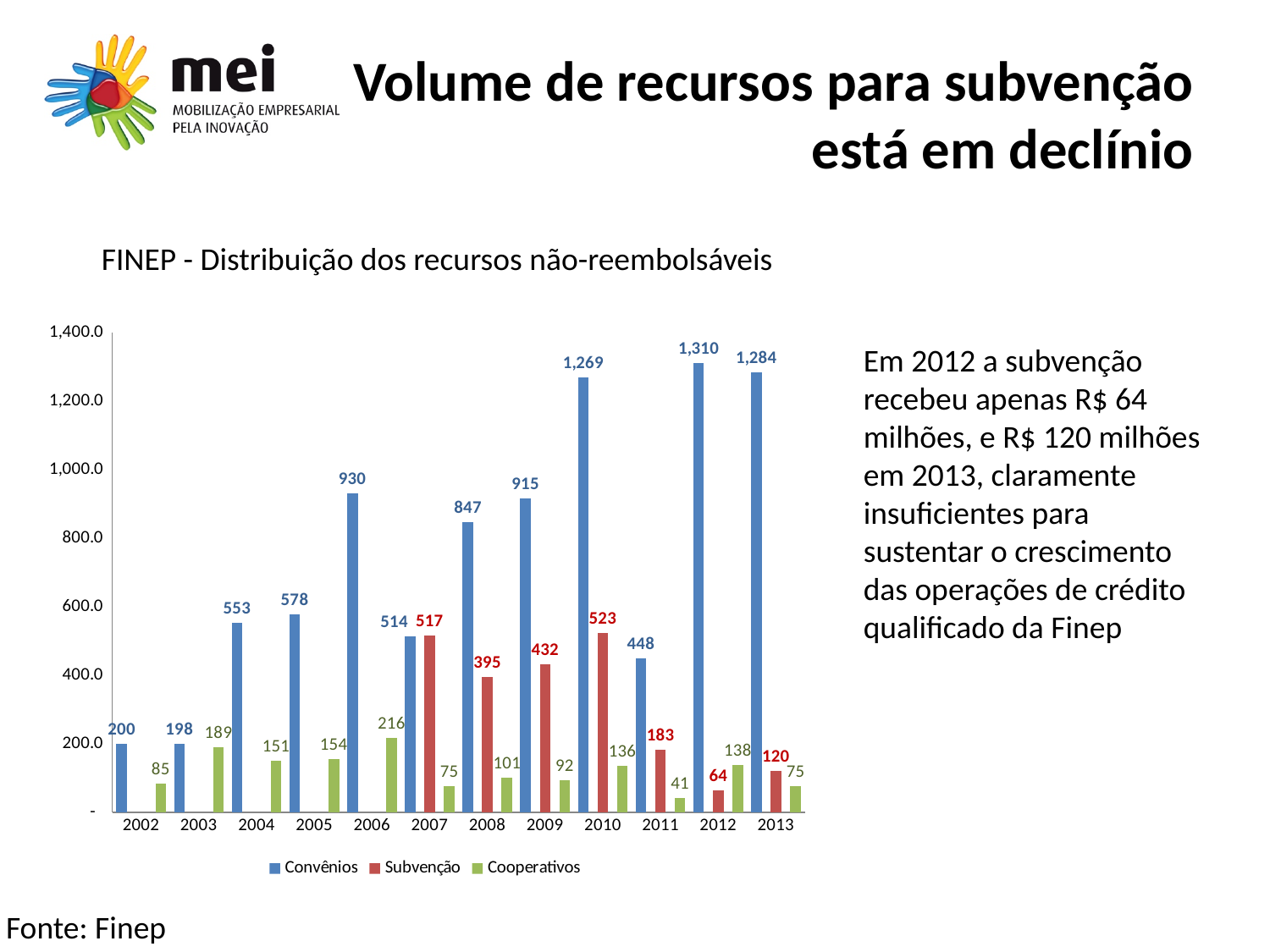
Is the Convênios value for 2011 greater or less than 400? greater What kind of chart is shown? Bar chart What is the value of Cooperativos in 2006? 216 How many years are shown on the x axis? 12 How many series does the legend list? 3 What is the difference between the Subvenção values in 2013 and 2012? 56 Which is larger in 2007, Convênios or Subvenção? Subvenção In which year is the Subvenção value lowest? 2012 What is the value of Convênios in 2012? 1,310 What is the value of Subvenção in 2010? 523 Does the Subvenção series rise or fall from 2010 to 2012? Fall In which year is the Convênios value highest? 2012